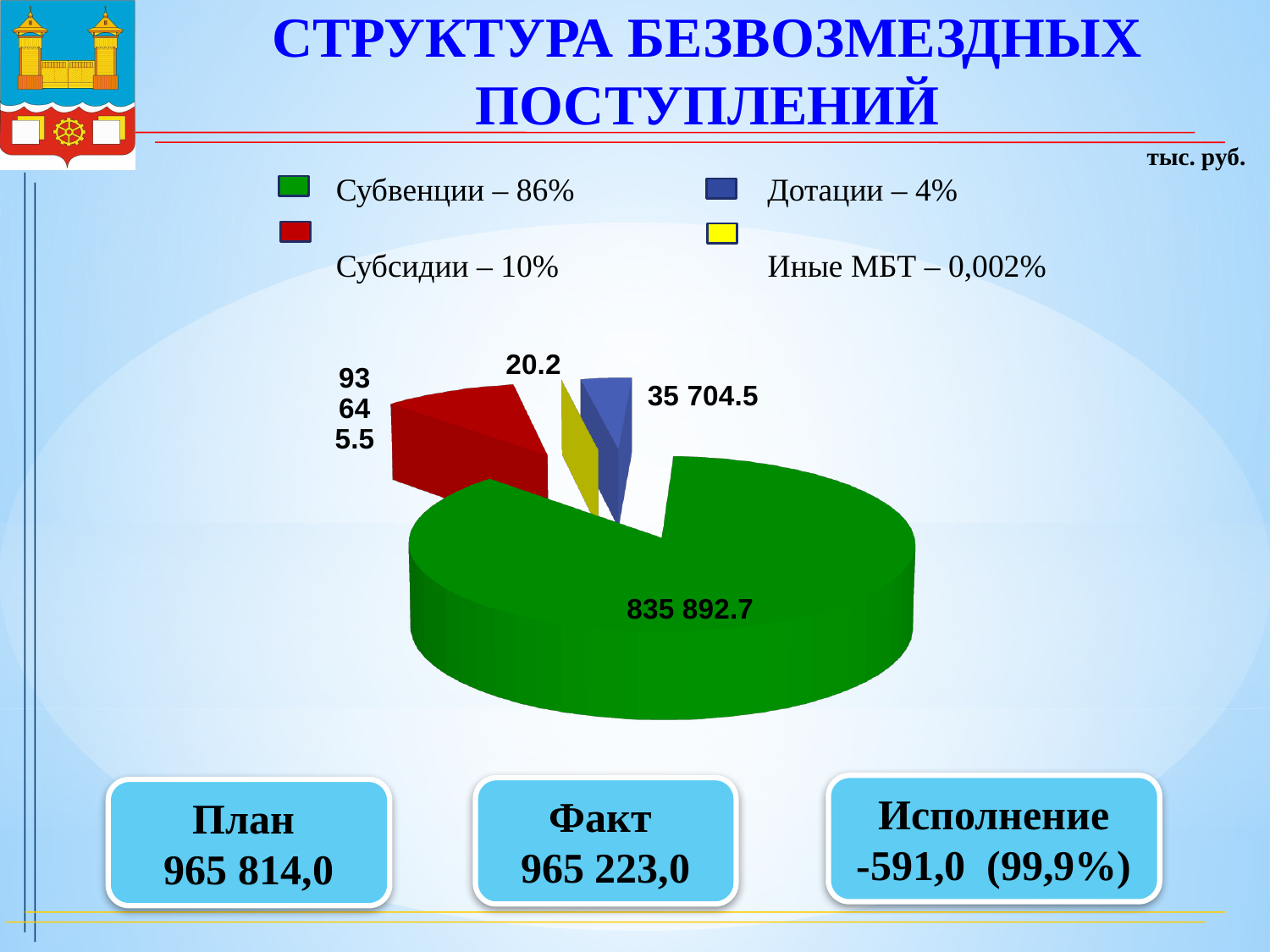
Which category has the largest slice of the pie chart? Субвенции What is the value shown for Иные МБТ on the pie chart? 20.2 What share of the pie does Субвенции represent according to the legend? 86% What is the value shown for Дотации on the pie chart? 35 704.5 What is the value shown for Субвенции on the pie chart? 835 892.7 What kind of chart is shown on the slide? Pie chart How many slices does the pie chart have? 4 What share of the pie does Субсидии represent according to the legend? 10% Which category has the smallest slice of the pie chart? Иные МБТ Which is larger, the value for Дотации or the value for Иные МБТ? Дотации What colour is the Субсидии slice in the pie chart? Red What is the difference between the values for Дотации and Иные МБТ? 35 684.3